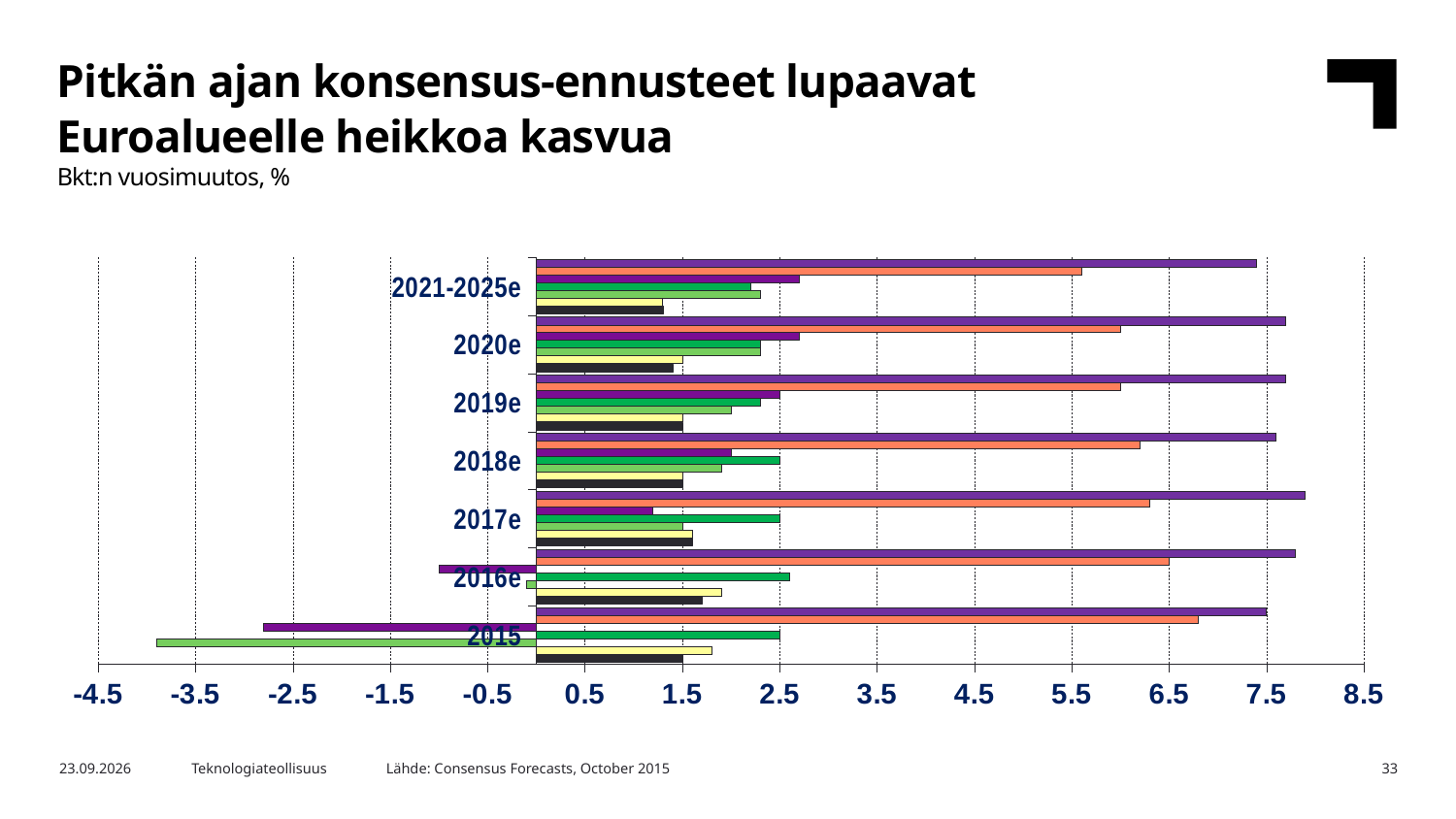
For 2015, which is larger: the dark purple bar or the orange bar? the dark purple bar What unit does the subtitle say the chart values are in? Bkt:n vuosimuutos, % Is the value of the black bar for 2021-2025e greater or less than 2.5? less Which year category has the lowest value for the light green bar? 2015 How many year categories are shown on the chart? 7 What kind of chart is shown on the slide? bar chart Is the value of the magenta bar for 2015 greater or less than -1.5? less Is the value of the light green bar for 2015 greater or less than -2.5? less How many bars are plotted for each year category? 7